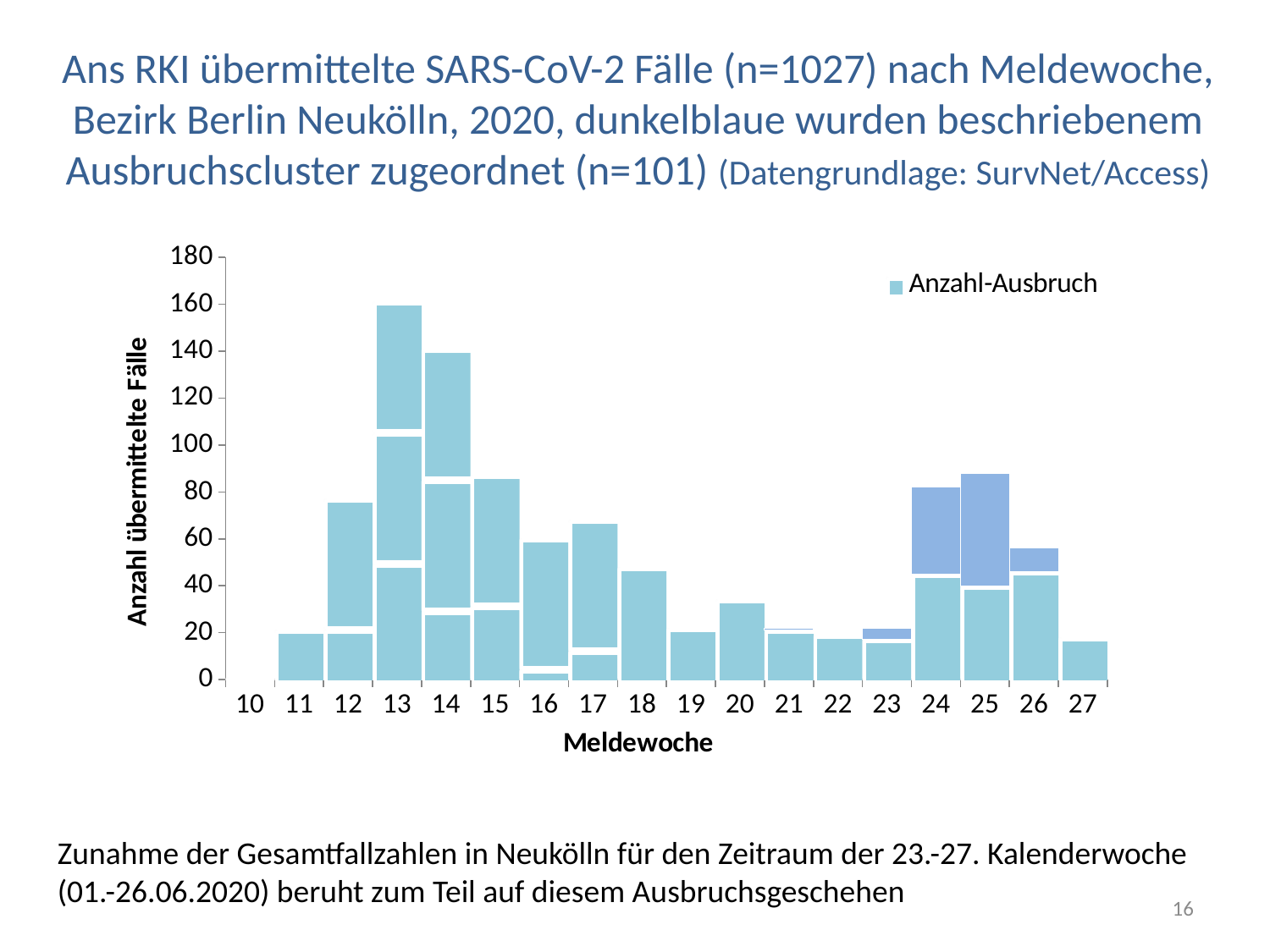
Is the value for Meldewoche 25 greater or less than 80? greater What is the title of the x axis? Meldewoche Which has a higher total, Meldewoche 13 or Meldewoche 14? Meldewoche 13 What kind of chart is shown on the slide? bar chart Which Meldewoche has the highest number of übermittelte Fälle? 13 Is the value for Meldewoche 14 greater or less than 120? greater Which has a higher total, Meldewoche 17 or Meldewoche 18? Meldewoche 17 Do the values rise or fall from Meldewoche 13 to Meldewoche 19? fall Is the value for Meldewoche 13 greater or less than 140? greater What entry does the legend show? Anzahl-Ausbruch